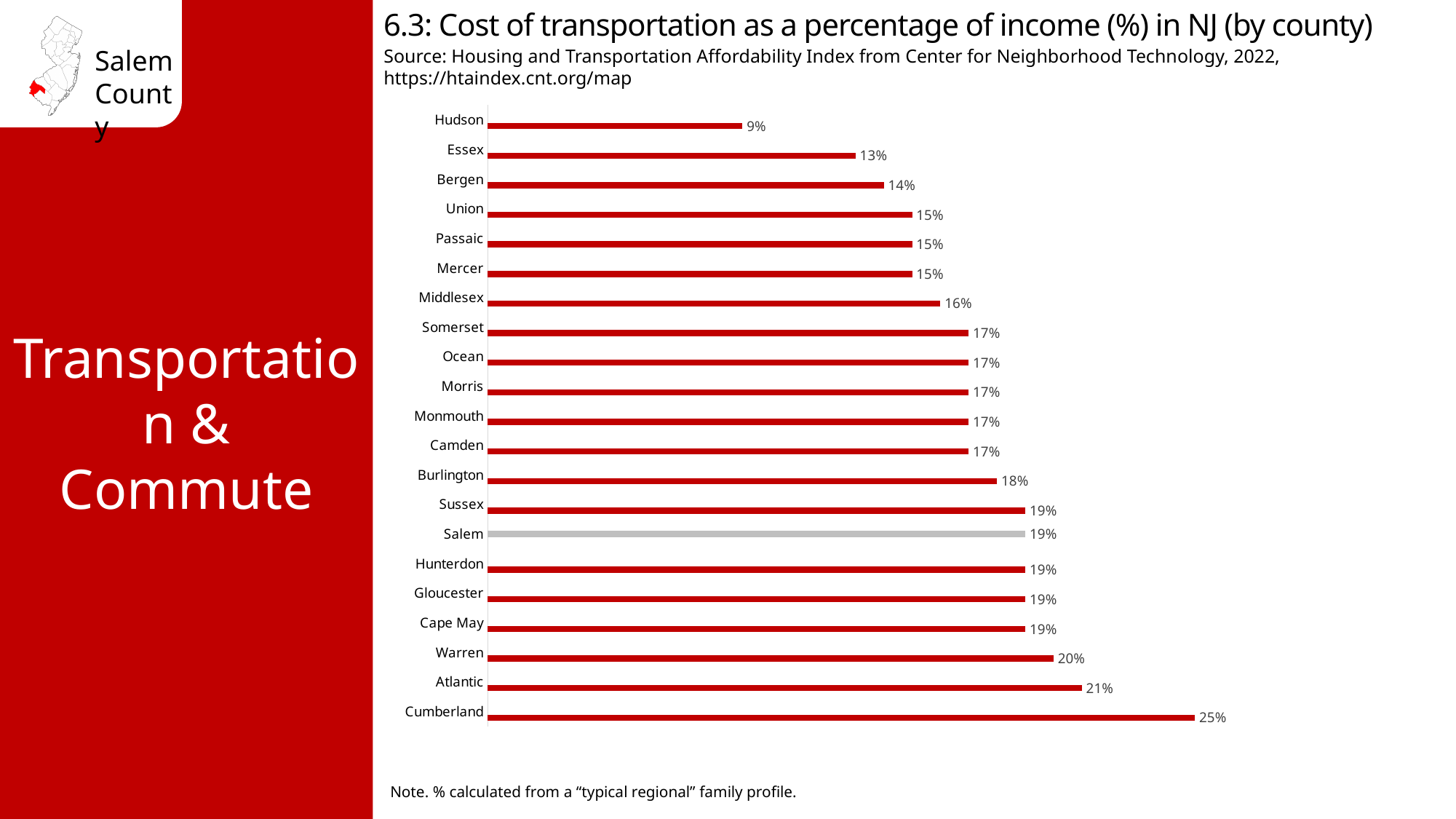
Which county has the lowest cost of transportation as a percentage of income? Hudson What is the value shown for Middlesex county? 16% Which county's bar is shown in grey rather than red? Salem Which has a higher value, Essex or Burlington? Burlington What is the cost of transportation as a percentage of income for Hudson county? 9% What is the difference between the values for Atlantic and Salem? 2% What is the cost of transportation as a percentage of income for Salem county? 19% What is the value shown for Cumberland county? 25% What kind of chart is shown on the slide? Bar chart Which county has the highest cost of transportation as a percentage of income? Cumberland How many counties are shown in the chart? 21 What is the difference between the values for Cumberland and Hudson? 16%